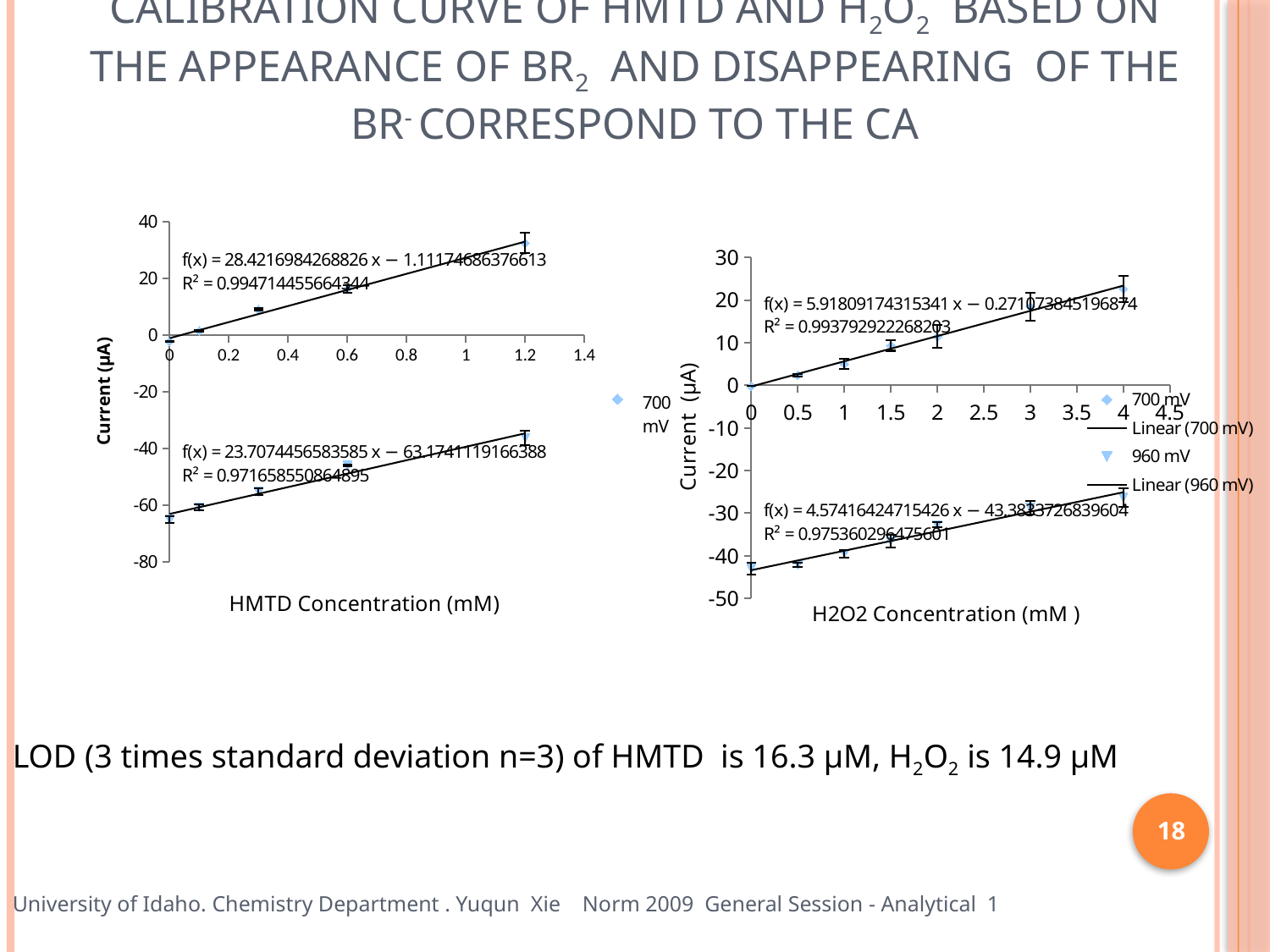
On the right chart (H2O2 Concentration), what is the slope printed in the equation of the upper trendline? 5.91809174315341 On the left chart (HMTD Concentration), is the current for the lower series at 1.2 mM greater or less than -60? greater What kind of chart is the left chart (HMTD Concentration)? scatter chart On the right chart (H2O2 Concentration), which series has the higher current at 2 mM, 700 mV or 960 mV? 700 mV On the left chart (HMTD Concentration), is the current for the upper series at 1.2 mM greater or less than 20? greater On the left chart (HMTD Concentration), what is the R² value printed for the upper trendline? 0.994714455664344 On the right chart (H2O2 Concentration), is the current for the 960 mV series at 0 mM greater or less than -30? less On the left chart (HMTD Concentration), what is the slope printed in the equation of the lower trendline? 23.7074456583585 On the left chart (HMTD Concentration), does the current for the upper series rise or fall as HMTD concentration increases? rise What is the x-axis title of the right chart? H2O2 Concentration (mM ) How many entries does the legend of the right chart (H2O2 Concentration) list? 4